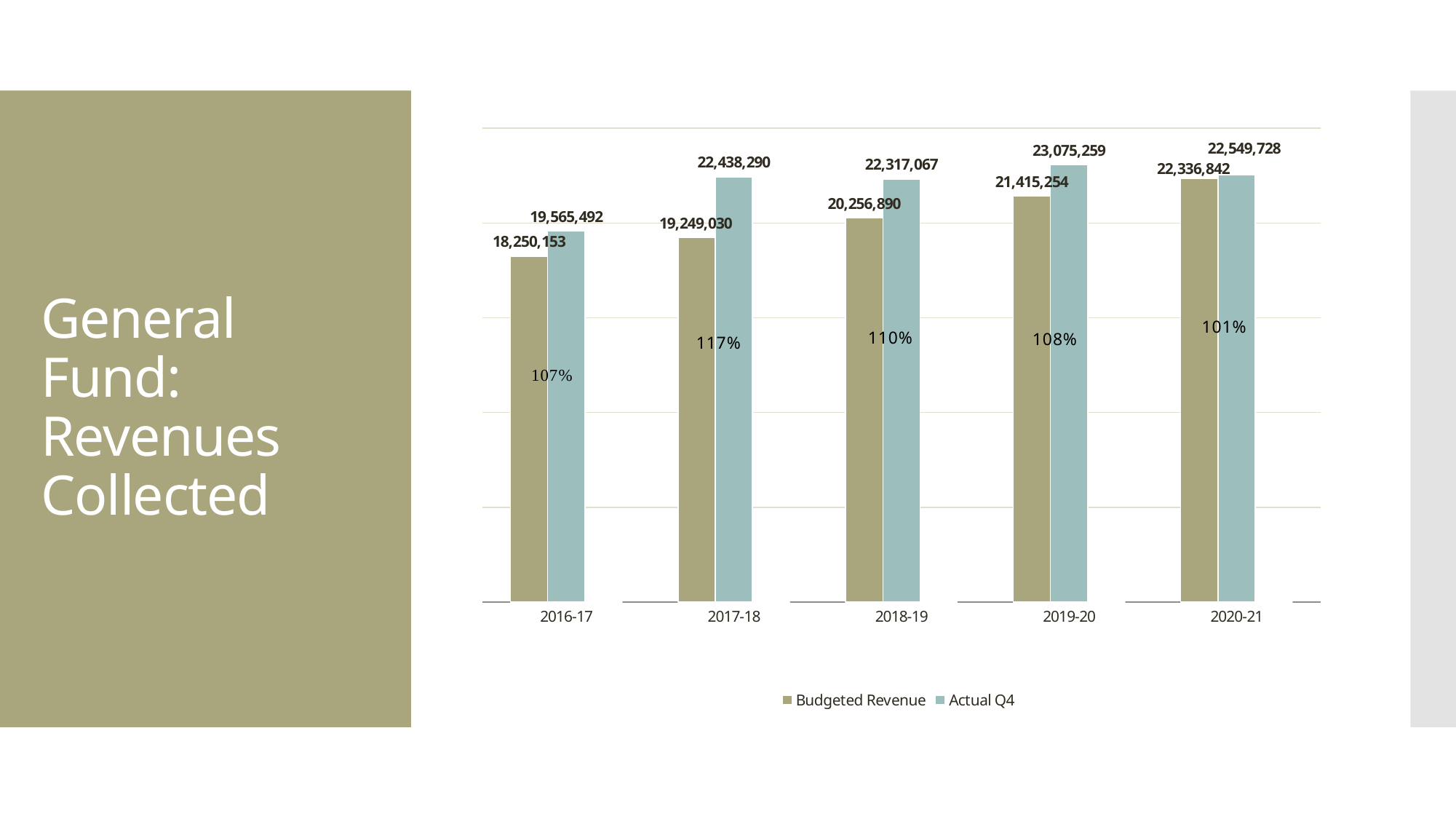
How many series does the legend list? 2 What is the difference between Actual Q4 and Budgeted Revenue for 2020-21? 212,886 Which is larger, the Actual Q4 value for 2017-18 or for 2018-19? 2017-18 What is the difference between Actual Q4 and Budgeted Revenue for 2016-17? 1,315,339 What is the Actual Q4 value for 2017-18? 22,438,290 Which year has the highest Actual Q4 value? 2019-20 What is the Actual Q4 value for 2019-20? 23,075,259 How many years are shown on the x axis? 5 Does the Budgeted Revenue rise or fall from 2016-17 to 2020-21? rise What is the Budgeted Revenue value for 2016-17? 18,250,153 What is the Budgeted Revenue value for 2020-21? 22,336,842 Which year has the lowest Budgeted Revenue value? 2016-17